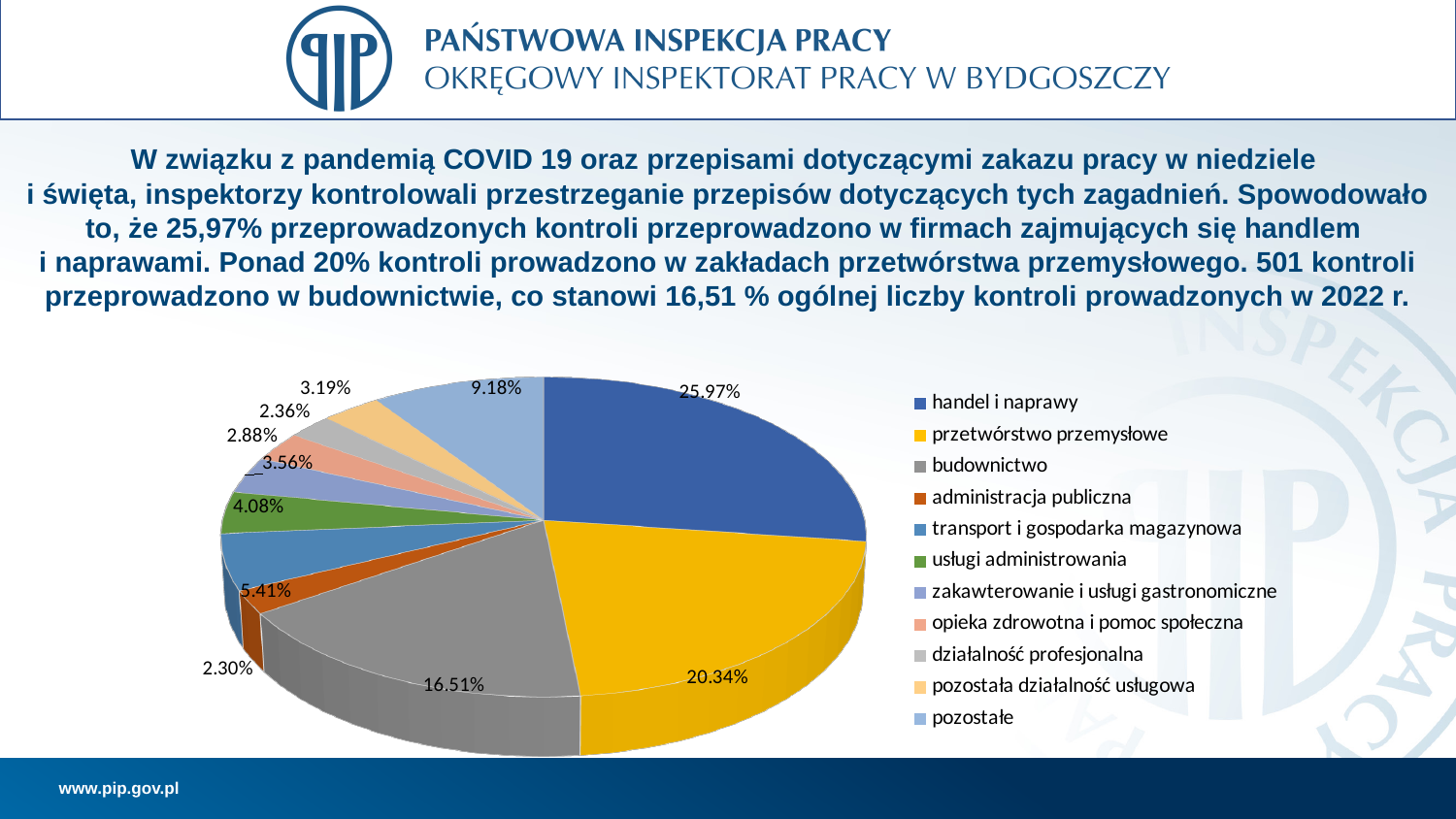
What is the difference between the 'handel i naprawy' and 'przetwórstwo przemysłowe' shares? 5.63% What colour is the 'przetwórstwo przemysłowe' slice? yellow What is the value shown for 'budownictwo'? 16.51% What is the value of the 'pozostałe' slice? 9.18% What kind of chart is shown on the slide? pie chart Which category has the largest slice of the pie? handel i naprawy What share of inspections does the 'handel i naprawy' slice represent? 25.97% What percentage is labelled for 'przetwórstwo przemysłowe'? 20.34% Which is larger: the share for 'transport i gospodarka magazynowa' or for 'usługi administrowania'? transport i gospodarka magazynowa Which category has the smallest slice of the pie? administracja publiczna What is the combined share of 'budownictwo' and 'administracja publiczna'? 18.81% How many categories does the legend list? 11